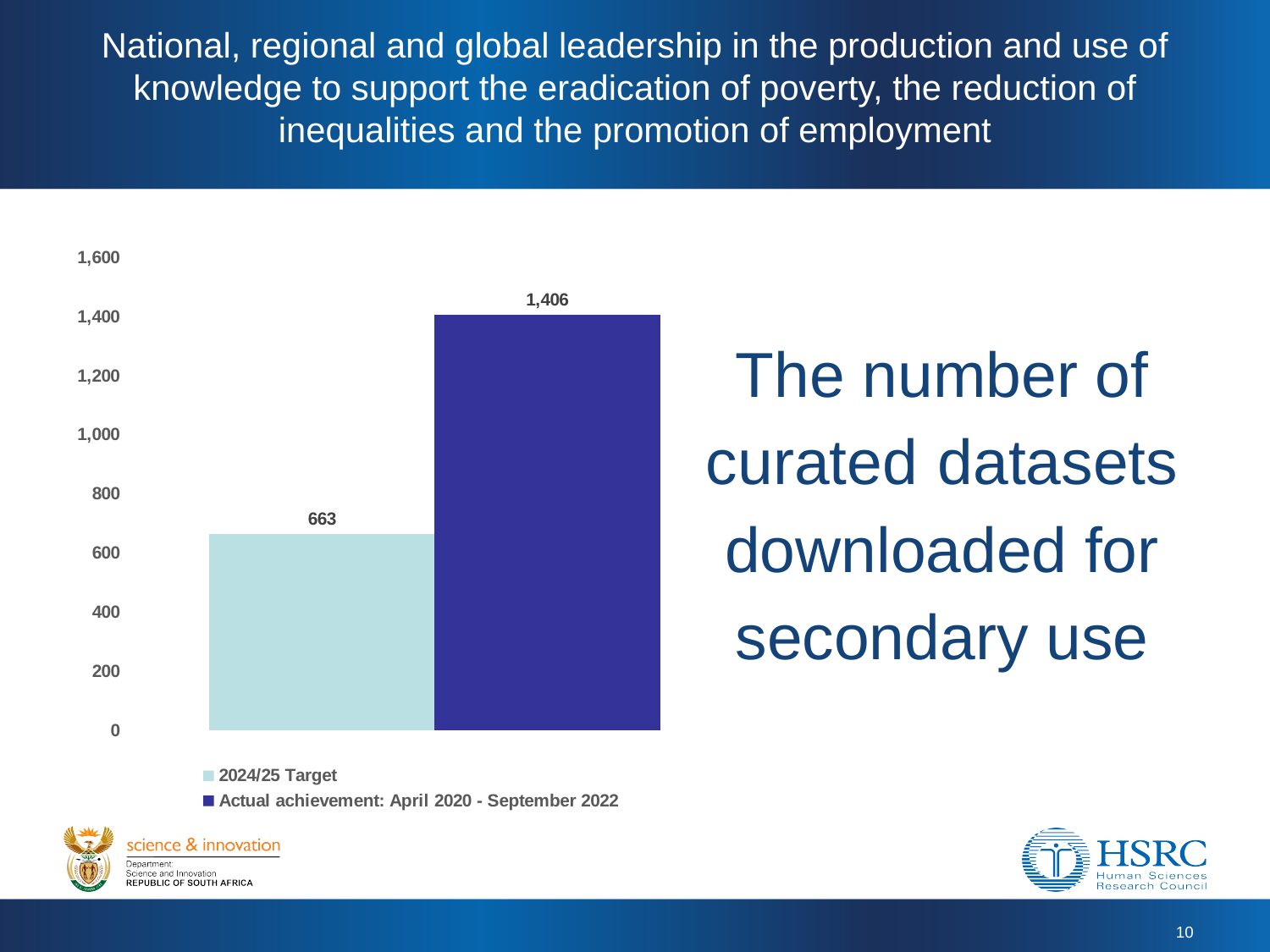
What is the value of the Actual achievement: April 2020 - September 2022 bar? 1,406 Which series has the higher value, the 2024/25 Target or the Actual achievement: April 2020 - September 2022? Actual achievement: April 2020 - September 2022 Is the value for the Actual achievement greater or less than 1,200? greater Which series has the lower value? 2024/25 Target What kind of chart is shown on the slide? bar chart What is the value of the 2024/25 Target bar? 663 What is the highest value shown on the vertical axis? 1,600 How many bars are plotted in the chart? 2 Is the Actual achievement value larger or smaller than the 2024/25 Target value? larger How many series does the legend list? 2 Is the value for the 2024/25 Target greater or less than 800? less What is the difference between the Actual achievement and the 2024/25 Target? 743